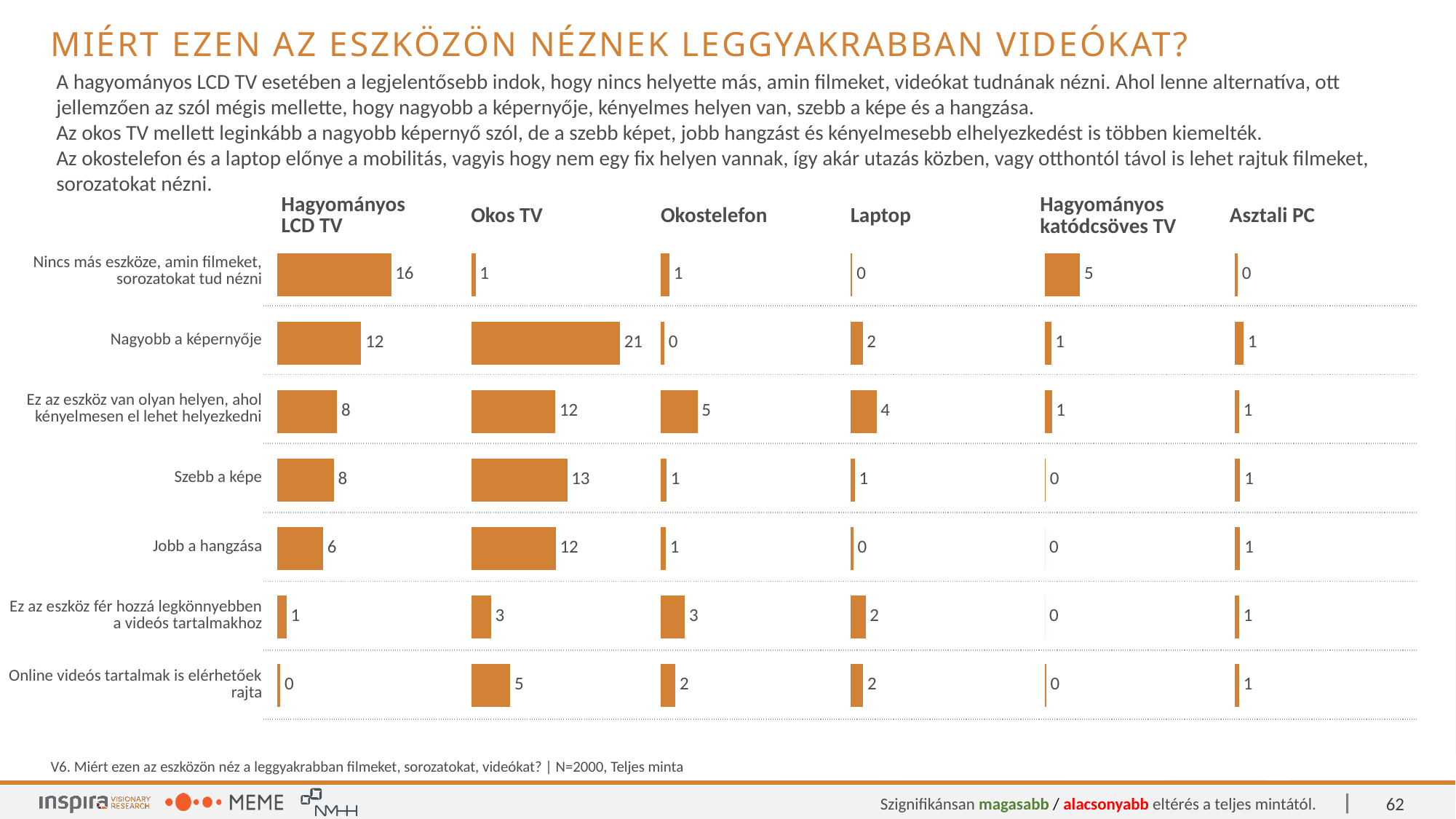
For "Jobb a hangzása", which is larger: the Okos TV value or the Hagyományos LCD TV value? Okos TV In the Hagyományos LCD TV chart, which category has the lowest value? Online videós tartalmak is elérhetőek rajta In the Okostelefon chart, what is the value for "Ez az eszköz van olyan helyen, ahol kényelmesen el lehet helyezkedni"? 5 In the Hagyományos katódcsöves TV chart, what is the value for "Nincs más eszköze, amin filmeket, sorozatokat tud nézni"? 5 What type of chart is used on the slide? Bar chart In the Okos TV chart, what is the value for "Nagyobb a képernyője"? 21 What is the difference between the Okos TV and Hagyományos LCD TV values for "Nagyobb a képernyője"? 9 How many categories (rows) are shown in each chart? 7 In the Okos TV chart, which category has the highest value? Nagyobb a képernyője In the Hagyományos LCD TV chart, what is the value for "Nincs más eszköze, amin filmeket, sorozatokat tud nézni"? 16 In the Laptop chart, what is the value for "Online videós tartalmak is elérhetőek rajta"? 2 How many device charts are shown on the slide? 6